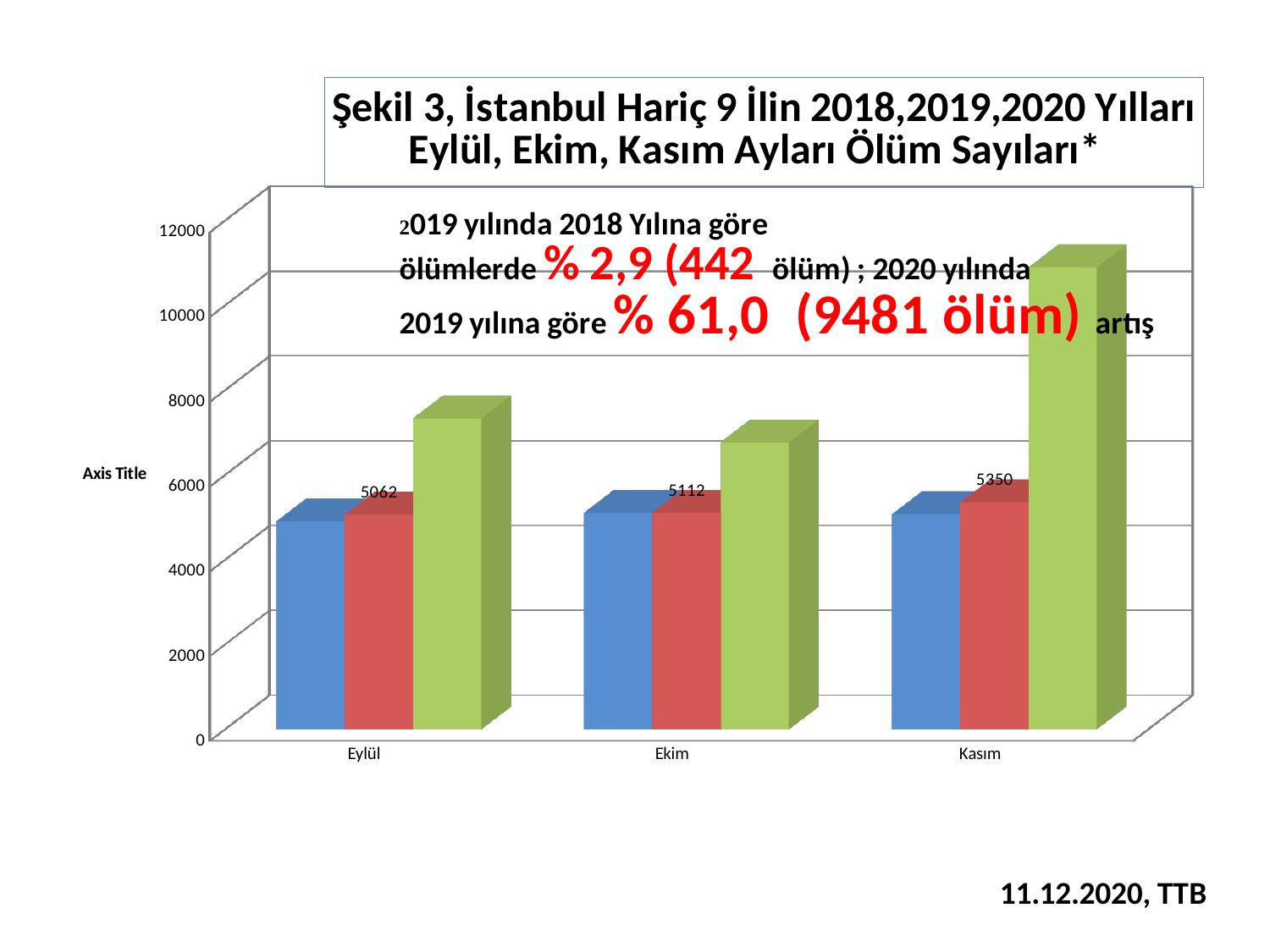
Which is larger, the green bar for Kasım or the green bar for Eylül? the green bar for Kasım What is the value of the red bar for Eylül? 5062 What is the value of the red bar for Kasım? 5350 How many month categories are shown on the x axis? 3 Is the value of the green bar for Kasım greater or less than 10000? greater What kind of chart is shown on the slide? bar chart What is the title of the chart? Şekil 3, İstanbul Hariç 9 İlin 2018,2019,2020 Yılları Eylül, Ekim, Kasım Ayları Ölüm Sayıları* What is the value of the red bar for Ekim? 5112 Is the value of the blue bar for Eylül greater or less than 6000? less Among the red bars, which month has the highest value? Kasım Among the red bars, which month has the lowest value? Eylül What is the difference between the red bar values for Kasım and Eylül? 288